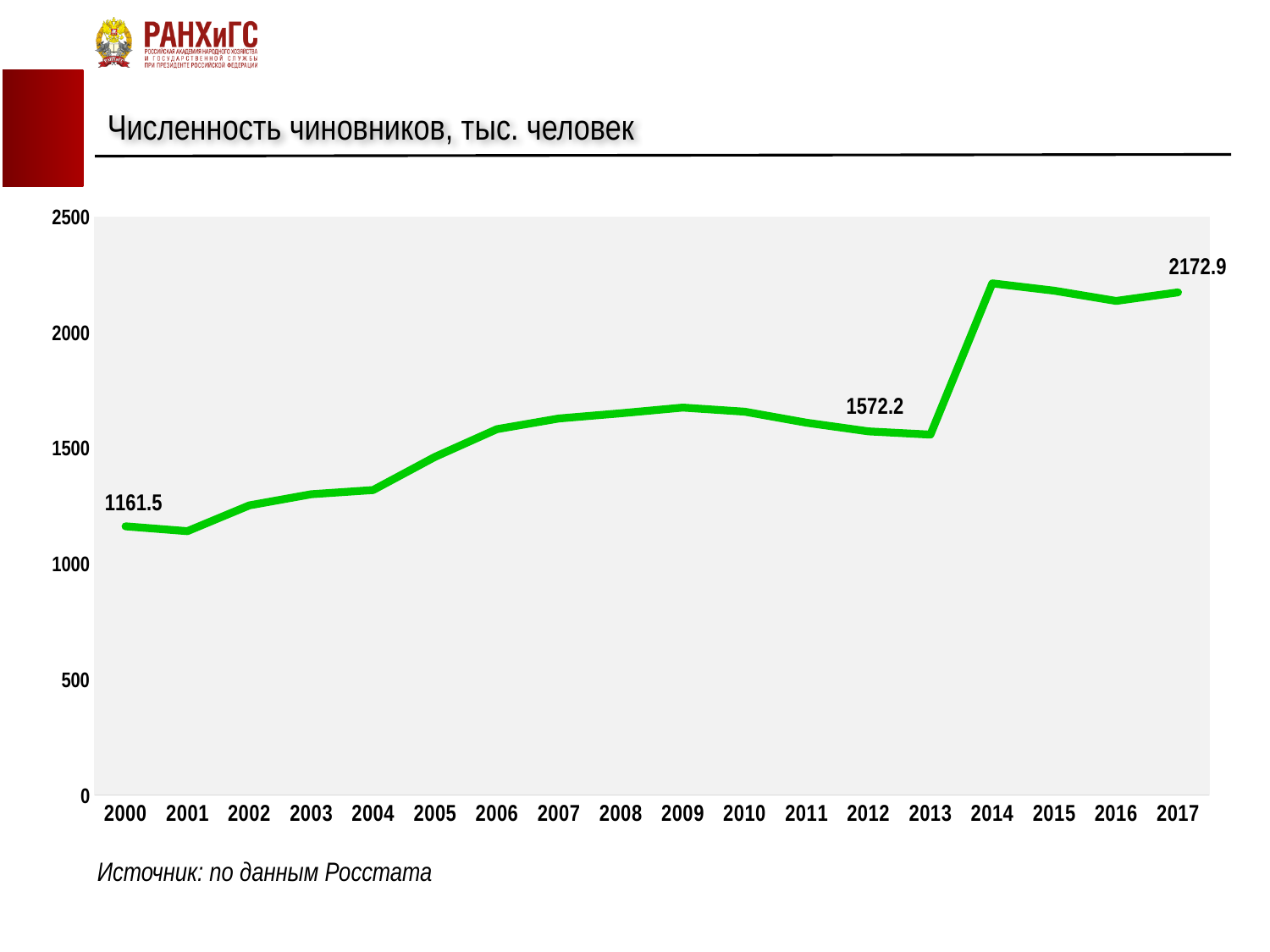
Do the values generally rise or fall from 2000 to 2017? rise Is the value for 2014 greater or less than 2000? greater What is the value for 2000? 1161.5 Is the value for 2009 greater or less than 1500? greater Is the value for 2004 greater or less than 1500? less What kind of chart is shown on the slide? line chart Which year has the larger value, 2000 or 2013? 2013 By how much does the value for 2017 exceed the value for 2000? 1011.4 What is the value for 2017? 2172.9 How many years are plotted on the x axis? 18